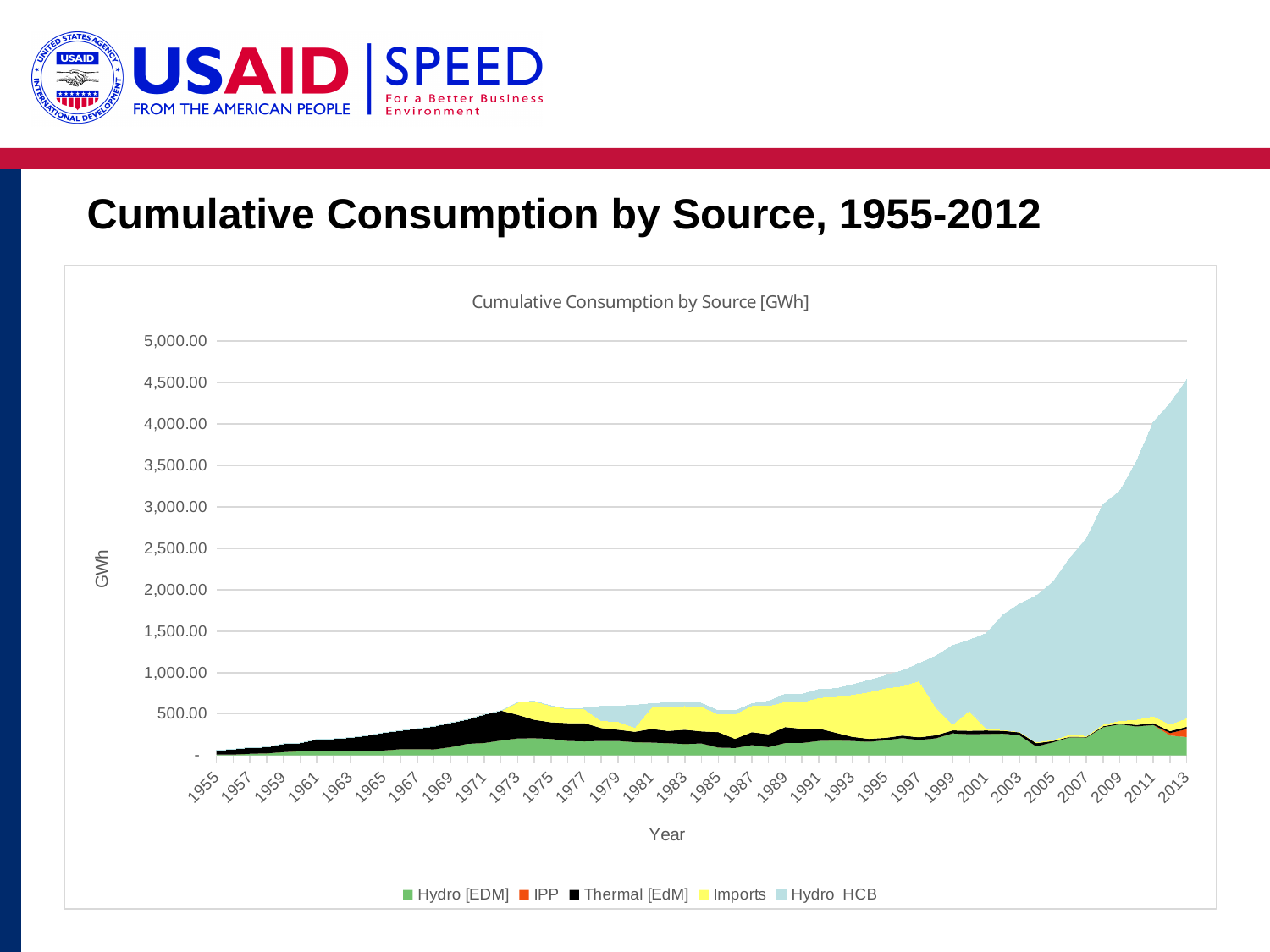
What label is shown on the vertical axis of the chart? GWh Does the total cumulative consumption generally rise or fall from 1955 to 2013? rise Is the total cumulative consumption in 2013 greater or less than 4,000.00 GWh? greater Which source contributes the largest share of consumption in 2013? Hydro HCB Is the total cumulative consumption in 2001 greater or less than 1,000.00 GWh? greater What is the title printed inside the chart area? Cumulative Consumption by Source [GWh] In 2013, which is larger: Hydro HCB or Imports? Hydro HCB What kind of chart is shown on the slide? Stacked area chart Is the total cumulative consumption in 1955 greater or less than 500.00 GWh? less How many series does the legend list? 5 Which series is plotted at the bottom of the stack? Hydro [EDM]